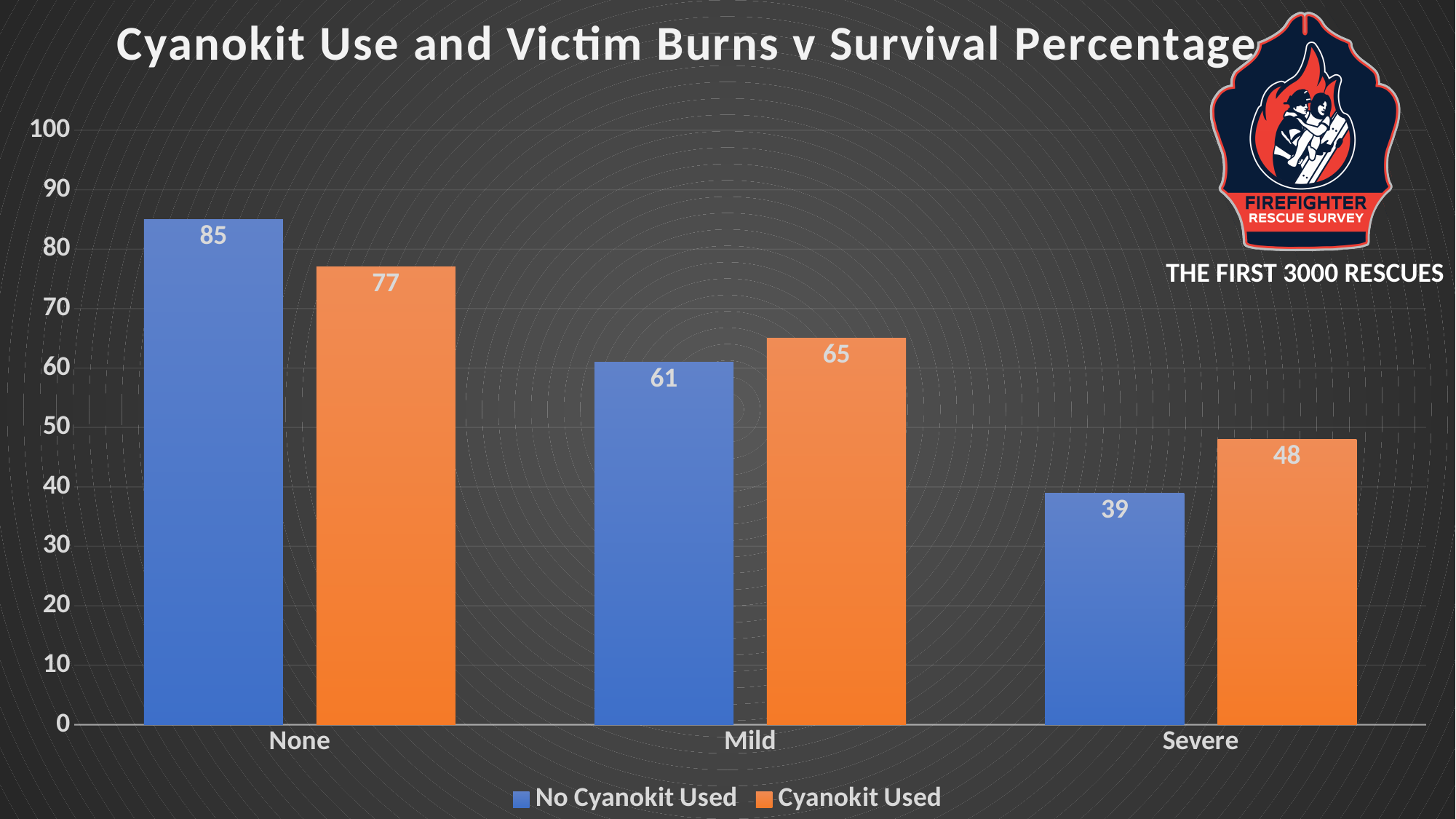
What is the value for Cyanokit Used in the Mild category? 65 Which burn category has the highest value for No Cyanokit Used? None What is the survival percentage for No Cyanokit Used in the None burn category? 85 Do the No Cyanokit Used values rise or fall from None to Severe? Fall What is the survival percentage for Cyanokit Used in the Severe burn category? 48 In the None category, which series has the larger value: No Cyanokit Used or Cyanokit Used? No Cyanokit Used Which burn category has the lowest value for Cyanokit Used? Severe How many series does the legend list? 2 What is the difference between the No Cyanokit Used and Cyanokit Used values in the Severe category? 9 In the Mild category, which series has the larger value: No Cyanokit Used or Cyanokit Used? Cyanokit Used How many burn categories are shown on the x axis? 3 What kind of chart is shown on the slide? Bar chart